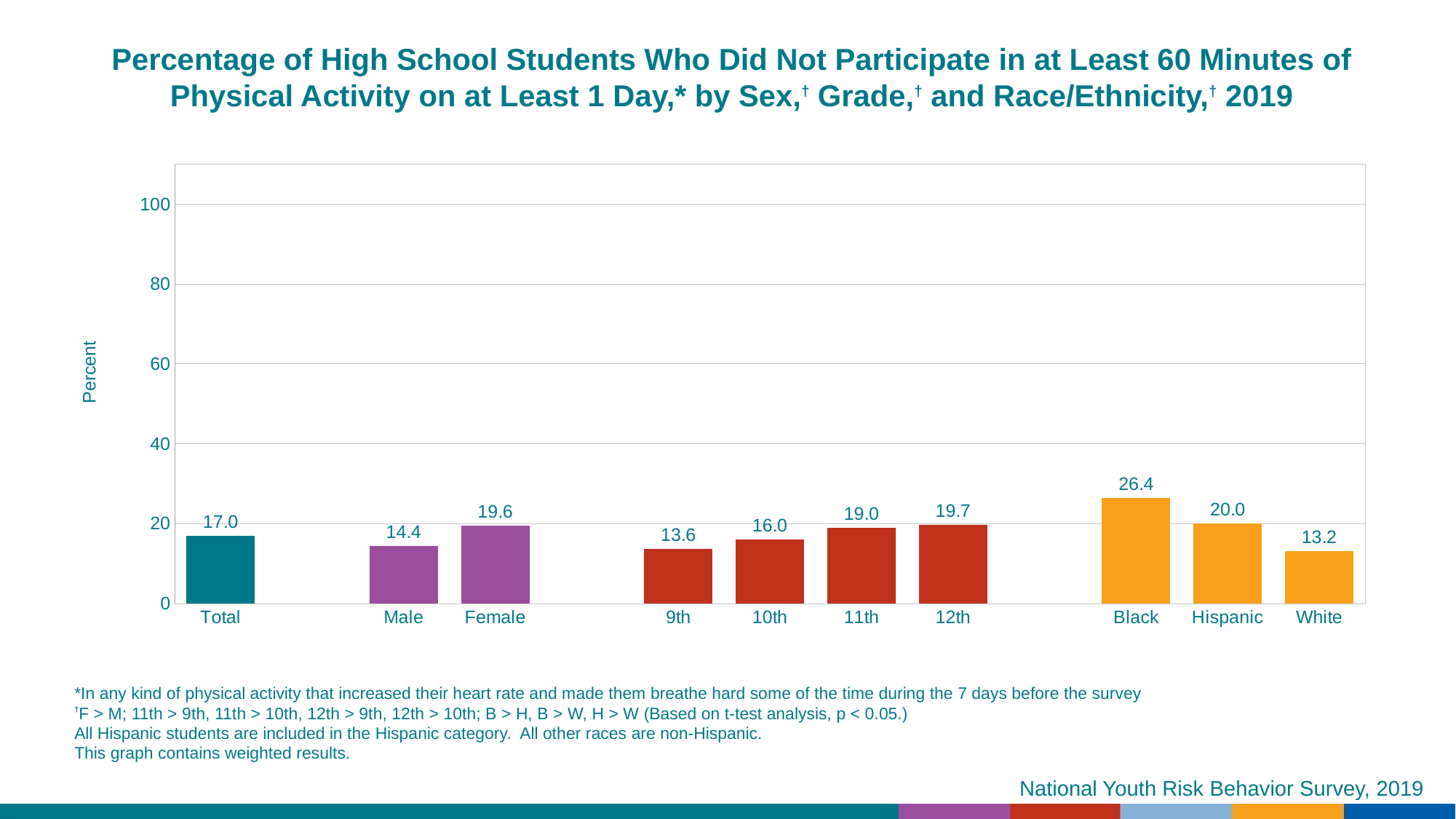
Do the values rise or fall from 9th grade to 12th grade? rise What is the value for Female? 19.6 What is the difference between the values for Black and Hispanic? 6.4 Which category has the highest value? Black How many categories are shown on the x axis? 10 What kind of chart is this? bar chart Which is larger, the value for 12th grade or the value for 9th grade? 12th Is the value for Black greater or less than 20? greater What is the value for 10th grade? 16.0 What is the difference between the values for Female and Male? 5.2 Which category has the lowest value? White What is the value for Total? 17.0